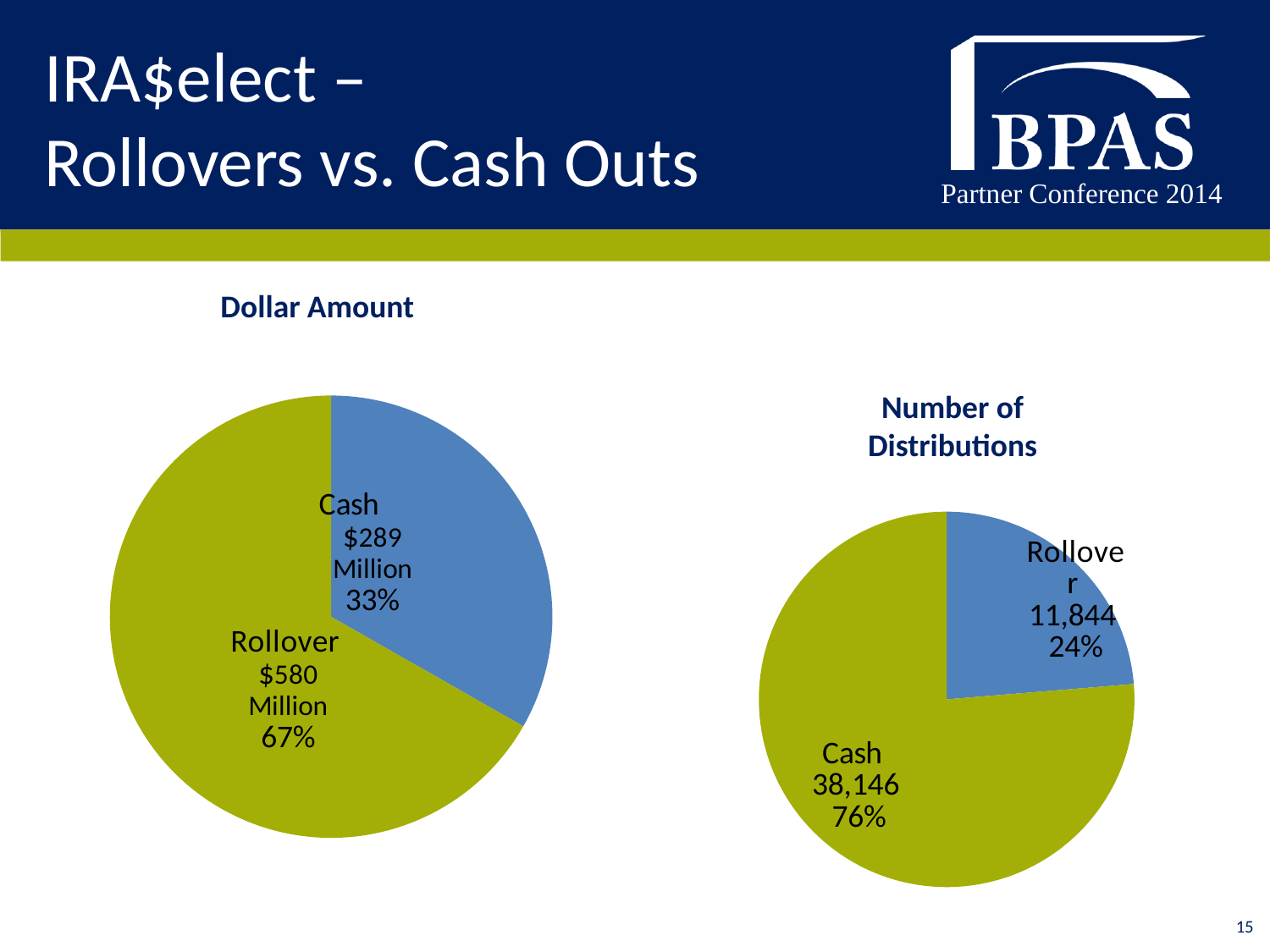
In the "Number of Distributions" chart, what is the value for Cash? 38,146 In the "Number of Distributions" chart, which is larger, Cash or Rollover? Cash In the "Number of Distributions" chart, what is the difference between the Cash and Rollover values? 26,302 In the "Dollar Amount" chart, which slice is the largest? Rollover In the "Dollar Amount" chart, what share of the pie does Cash represent? 33% In the "Number of Distributions" chart, what share of the pie does Rollover represent? 24% What kind of chart is the "Dollar Amount" chart? Pie chart In the "Number of Distributions" chart, what is the value for Rollover? 11,844 In the "Dollar Amount" chart, what is the value for Cash? $289 Million In the "Number of Distributions" chart, which slice is the smallest? Rollover In the "Dollar Amount" chart, what is the value for Rollover? $580 Million How many slices does the "Number of Distributions" chart have? 2